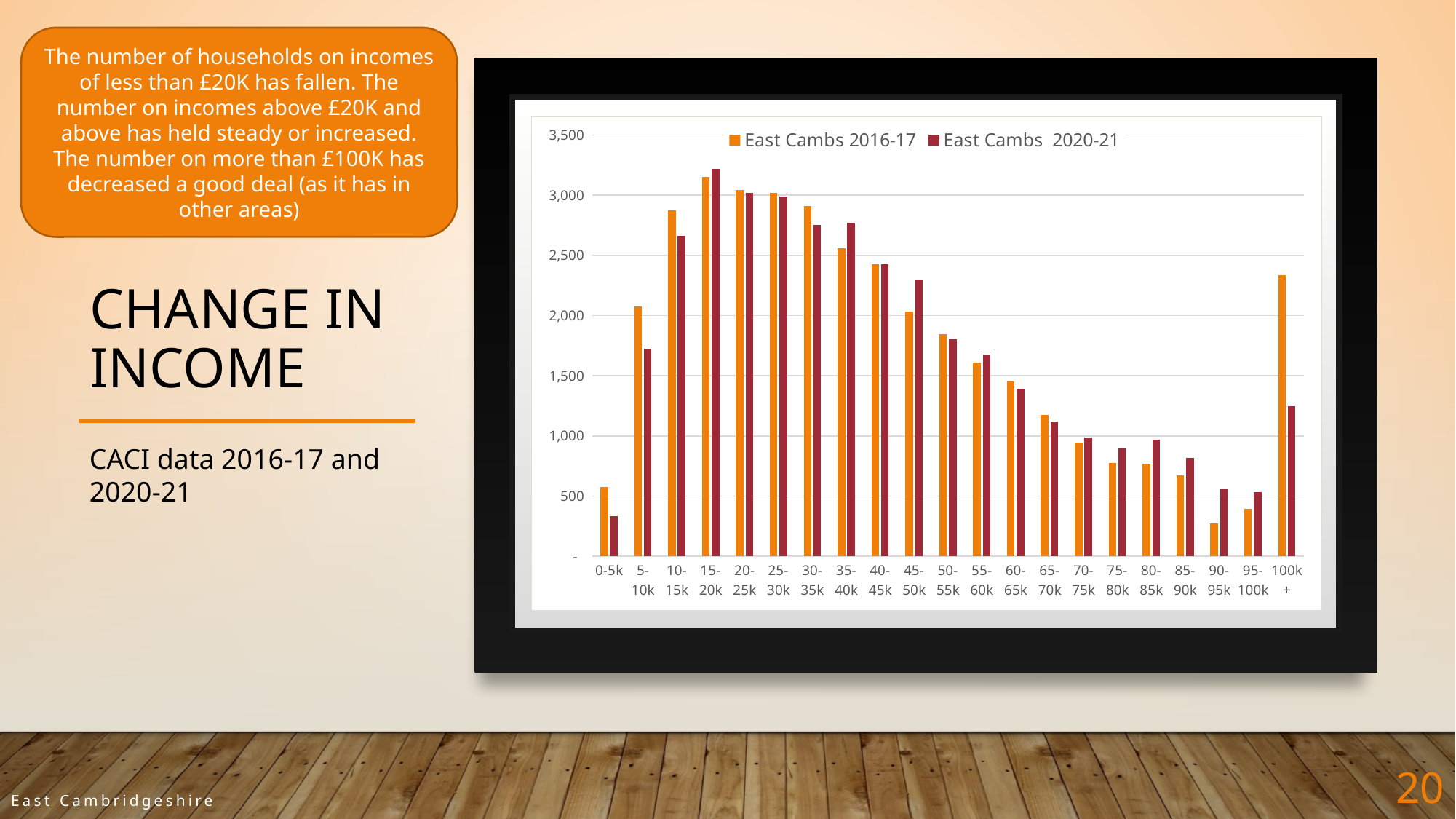
How many income bands are shown on the x axis of the chart? 21 For the 5-10k income band, which series has the larger value, East Cambs 2016-17 or East Cambs 2020-21? East Cambs 2016-17 Which income band has the highest value for East Cambs 2020-21? 15-20k Which income band has the highest value for East Cambs 2016-17? 15-20k Is the East Cambs 2016-17 value for 100k+ greater or less than 2,000? greater For the 45-50k income band, which series has the larger value, East Cambs 2016-17 or East Cambs 2020-21? East Cambs 2020-21 Is the East Cambs 2020-21 value for 45-50k greater or less than 2,500? less How many series does the chart legend list? 2 Which income band has the lowest value for East Cambs 2016-17? 90-95k Which income band has the lowest value for East Cambs 2020-21? 0-5k What type of chart is shown on the slide? bar chart Is the East Cambs 2016-17 value for 90-95k greater or less than 500? less